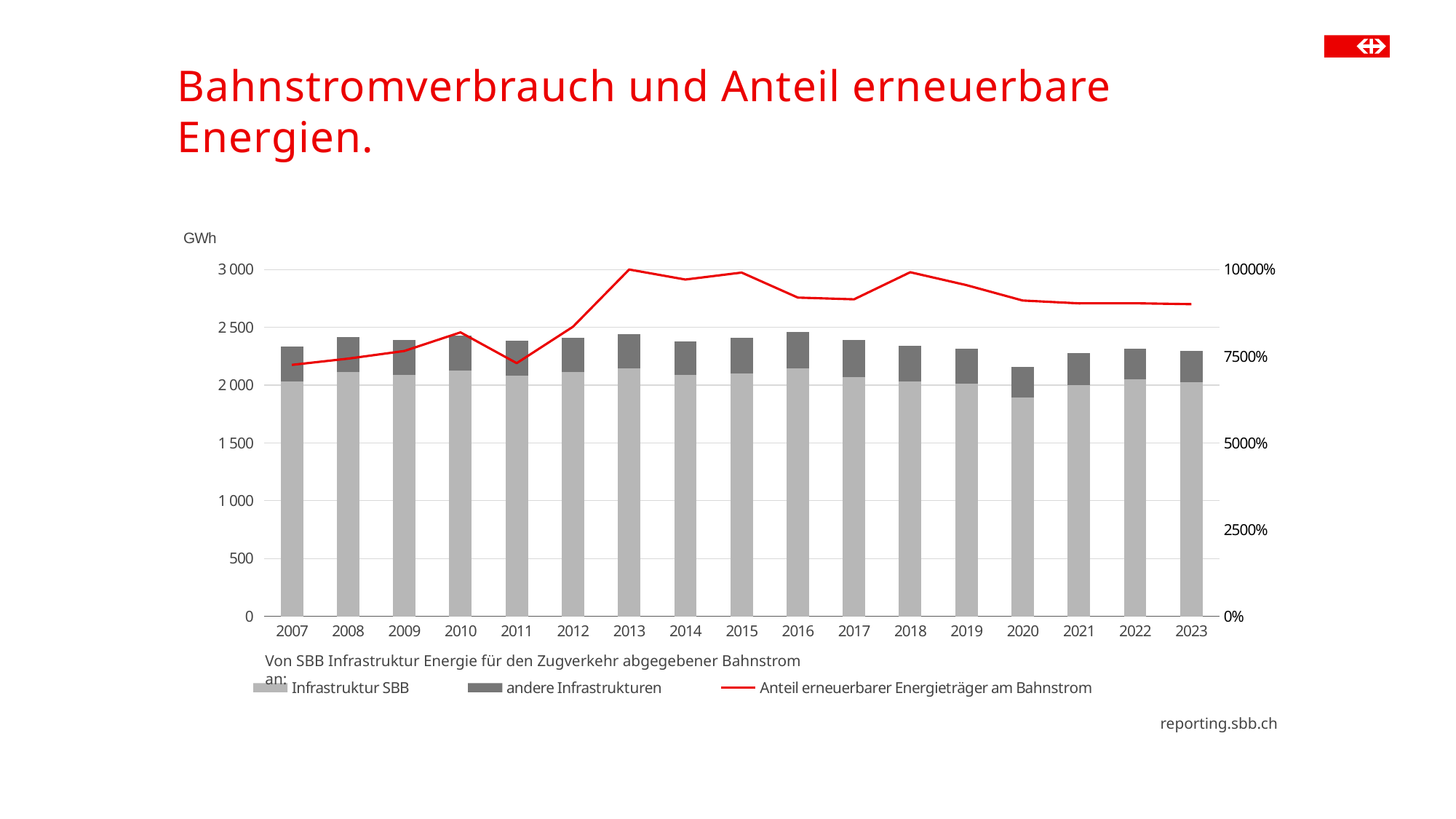
Is the total bar for 2016 greater or less than 2 000 GWh? greater Is the Infrastruktur SBB segment for 2020 greater or less than 2 000 GWh? less How many series does the chart legend list? 3 Is the total bar for 2020 greater or less than 2 500 GWh? less How many years are shown on the x axis of the chart? 17 What unit is shown on the left vertical axis of the chart? GWh Does the line 'Anteil erneuerbarer Energieträger am Bahnstrom' rise or fall from 2018 to 2023? fall Which year has the lowest total bar (Bahnstromverbrauch)? 2020 What kind of chart is shown on the slide? Combined stacked bar chart with a line Which year has the larger total bar, 2016 or 2020? 2016 Does the line 'Anteil erneuerbarer Energieträger am Bahnstrom' rise or fall from 2007 to 2013? rise